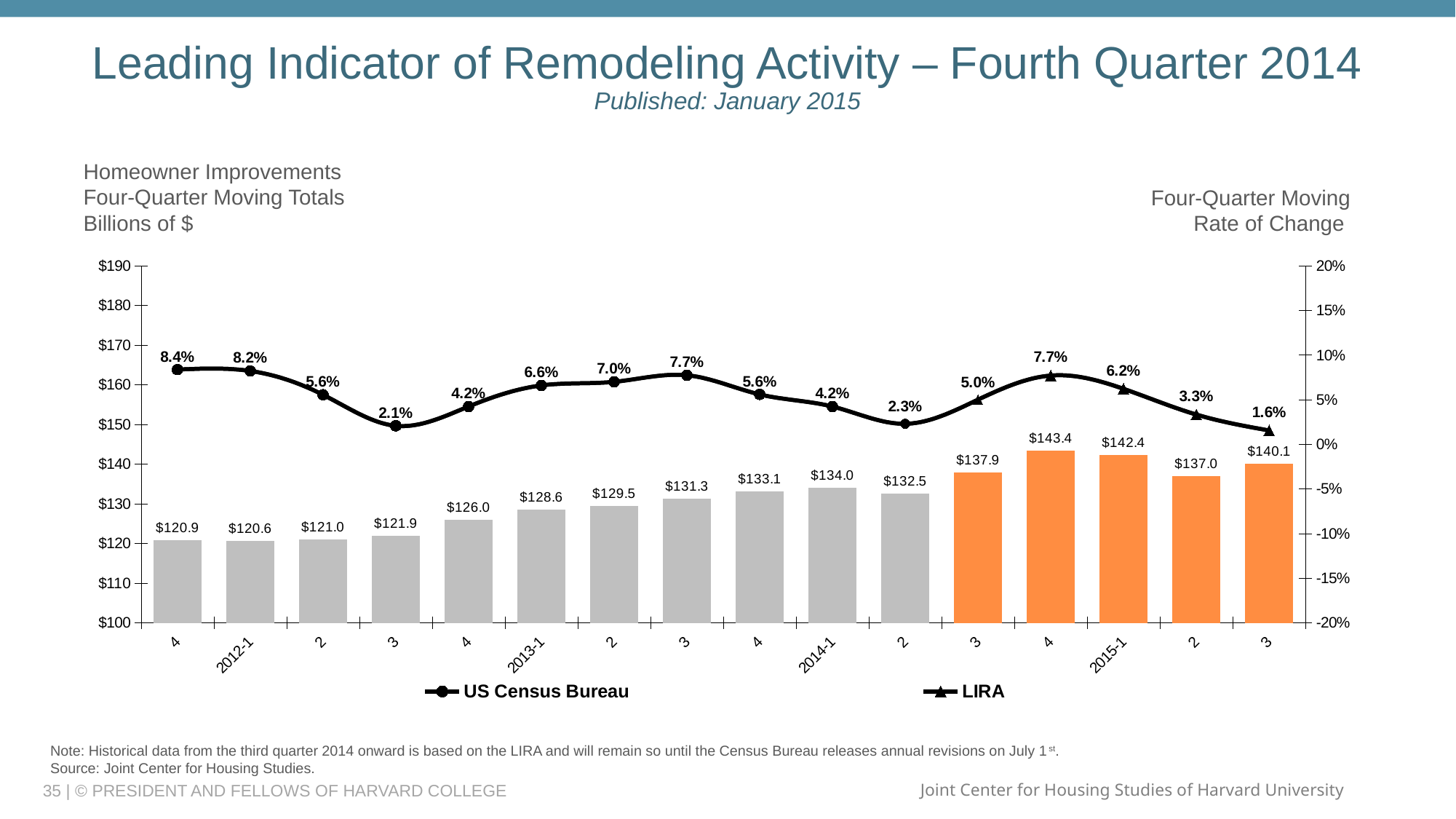
Which quarter has the highest four-quarter moving total bar? 2014-4 (the '4' after 2014-1), $143.4 What kind of chart is this? Combination bar and line chart How many bars (quarters) are plotted in the chart? 16 What is the four-quarter moving total shown for 2015-1? $142.4 Which quarter has the lowest four-quarter moving rate of change on the line? 2015-3 (the last point), 1.6% What are the two series named in the legend? US Census Bureau and LIRA What is the difference between the four-quarter moving totals for 2014-1 ($134.0) and 2013-1 ($128.6)? $5.4 Which is larger, the rate of change for 2012-1 or for 2015-1? 2012-1 (8.2%) How many series does the legend list? 2 What is the four-quarter moving total (billions of $) shown for 2014-1? $134.0 What is the four-quarter moving rate of change shown for 2013-1? 6.6% Do the four-quarter moving totals generally rise or fall from the first bar ($120.9) to 2014-1 ($134.0)? Rise